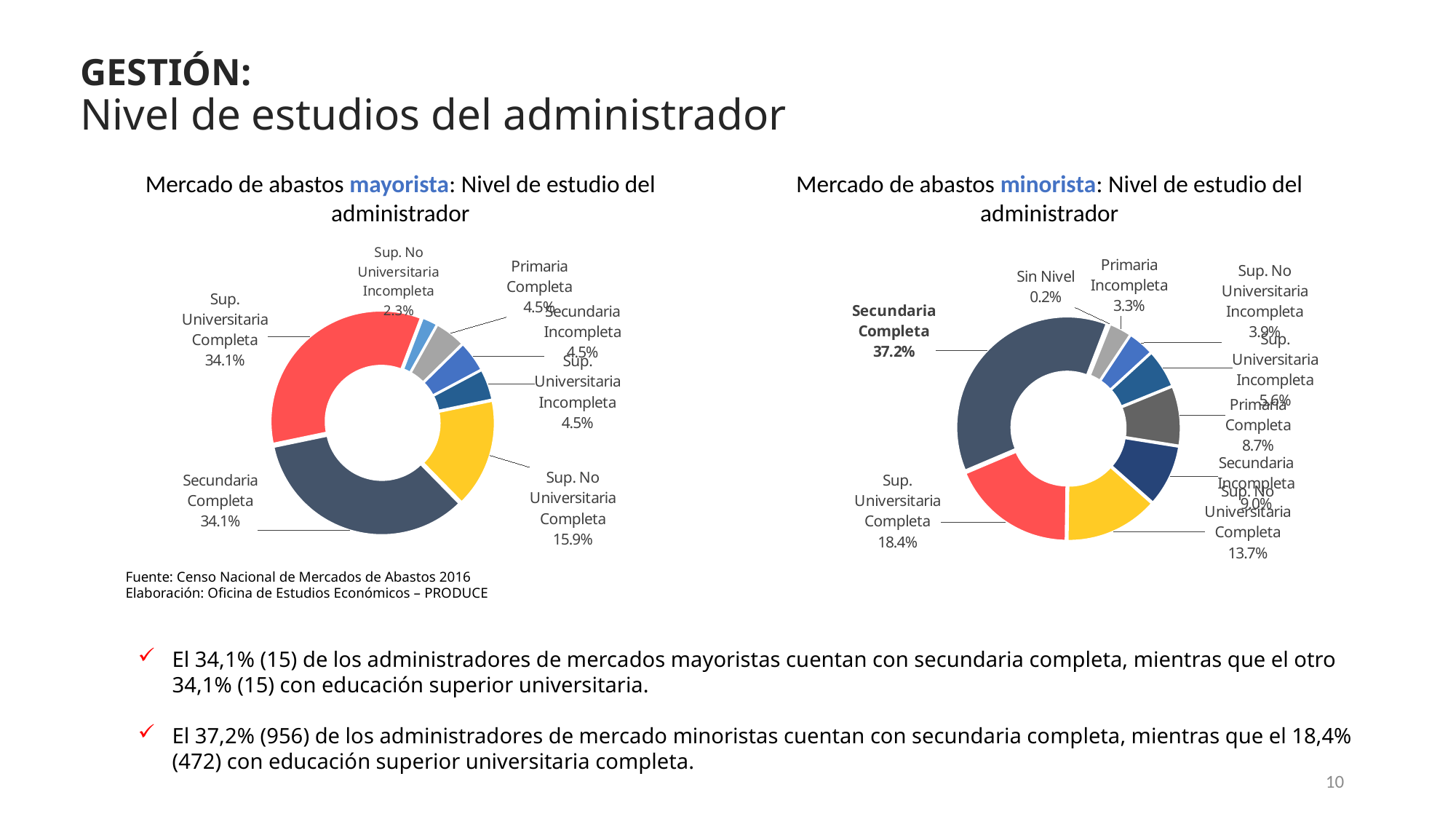
In the 'Mercado de abastos minorista' chart, which is larger: Primaria Completa or Sup. No Universitaria Completa? Sup. No Universitaria Completa In the 'Mercado de abastos minorista' chart, which category has the smallest share? Sin Nivel In the 'Mercado de abastos minorista' chart, what share of administrators have Sup. Universitaria Completa? 18.4% In the 'Mercado de abastos mayorista' chart, what share of administrators have Secundaria Completa? 34.1% In the 'Mercado de abastos minorista' chart, what is the difference between Secundaria Completa and Sup. Universitaria Completa? 18.8% In the 'Mercado de abastos minorista' chart, which category has the largest share? Secundaria Completa In the 'Mercado de abastos minorista' chart, what share of administrators have Secundaria Completa? 37.2% What type of chart is used on this slide? Pie (donut) chart In the 'Mercado de abastos mayorista' chart, how many categories are shown? 7 In the 'Mercado de abastos minorista' chart, how many categories are shown? 9 In the 'Mercado de abastos mayorista' chart, what share of administrators have Sup. No Universitaria Completa? 15.9% In the 'Mercado de abastos mayorista' chart, which category has the smallest share? Sup. No Universitaria Incompleta